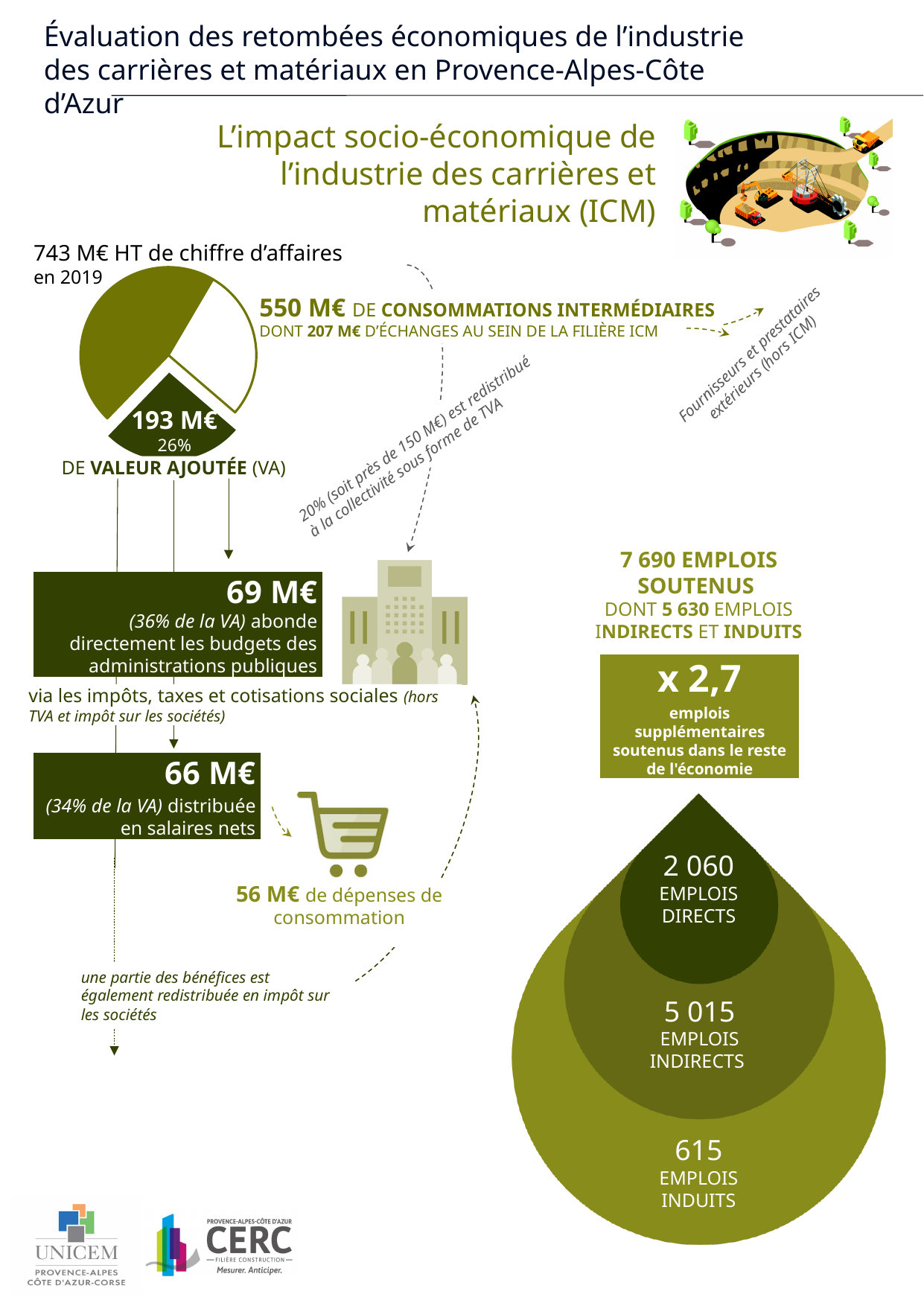
In the pie chart of the 743 M€ turnover, what is the difference between consommations intermédiaires and valeur ajoutée? 357 M€ In the nested circle diagram of jobs on the right, what is the difference between emplois indirects and emplois directs? 2 955 How many slices does the pie chart of the 743 M€ turnover have? 3 In the nested circle diagram of jobs on the right, which category has the lowest number of jobs? Emplois induits What kind of chart is used to show the split of the 743 M€ chiffre d'affaires? Pie chart In the pie chart of the 743 M€ turnover, what value is given for consommations intermédiaires? 550 M€ In the pie chart of the 743 M€ turnover, what value is shown for the valeur ajoutée (VA) slice? 193 M€ In the nested circle diagram of jobs on the right, how many emplois directs are shown? 2 060 In the nested circle diagram of jobs on the right, how many emplois induits are shown? 615 In the nested circle diagram of jobs on the right, which category has the highest number of jobs? Emplois indirects In the pie chart of the 743 M€ turnover, which is larger: consommations intermédiaires or valeur ajoutée? Consommations intermédiaires In the pie chart of the 743 M€ turnover, what share of the total does the valeur ajoutée slice represent? 26%